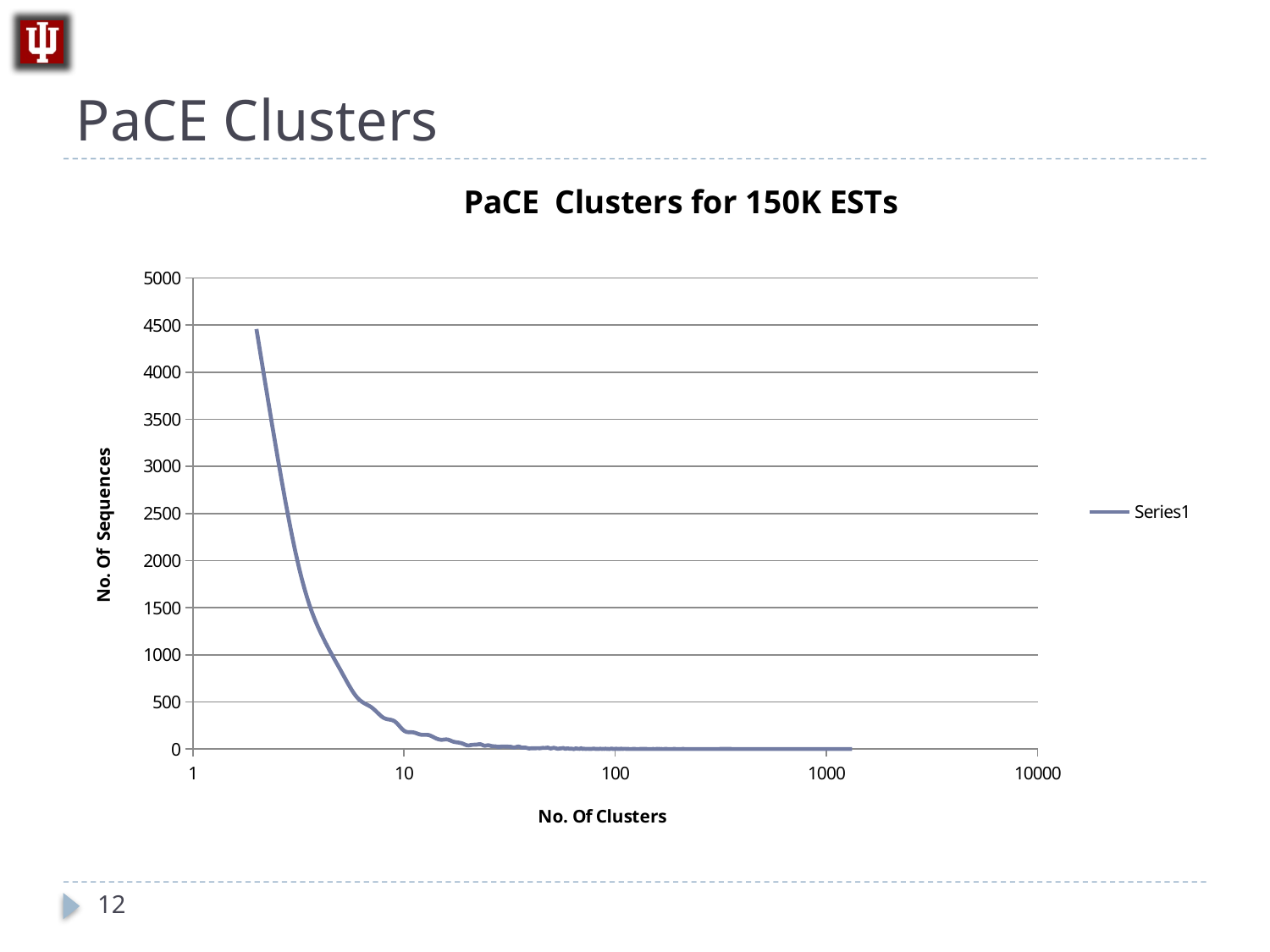
Is the highest value of Series1 on the chart greater or less than 4000 sequences? greater How many series does the chart legend list? 1 What is the highest tick value shown on the x axis? 10000 What is the highest tick value shown on the y axis? 5000 Does the number of sequences rise or fall as the number of clusters increases along the x axis? fall What kind of chart is shown on the slide? line chart Is the value of Series1 at 1000 clusters greater or less than 500 sequences? less Is the value of Series1 at 10 clusters greater or less than 500 sequences? less What is the title of the chart? PaCE Clusters for 150K ESTs